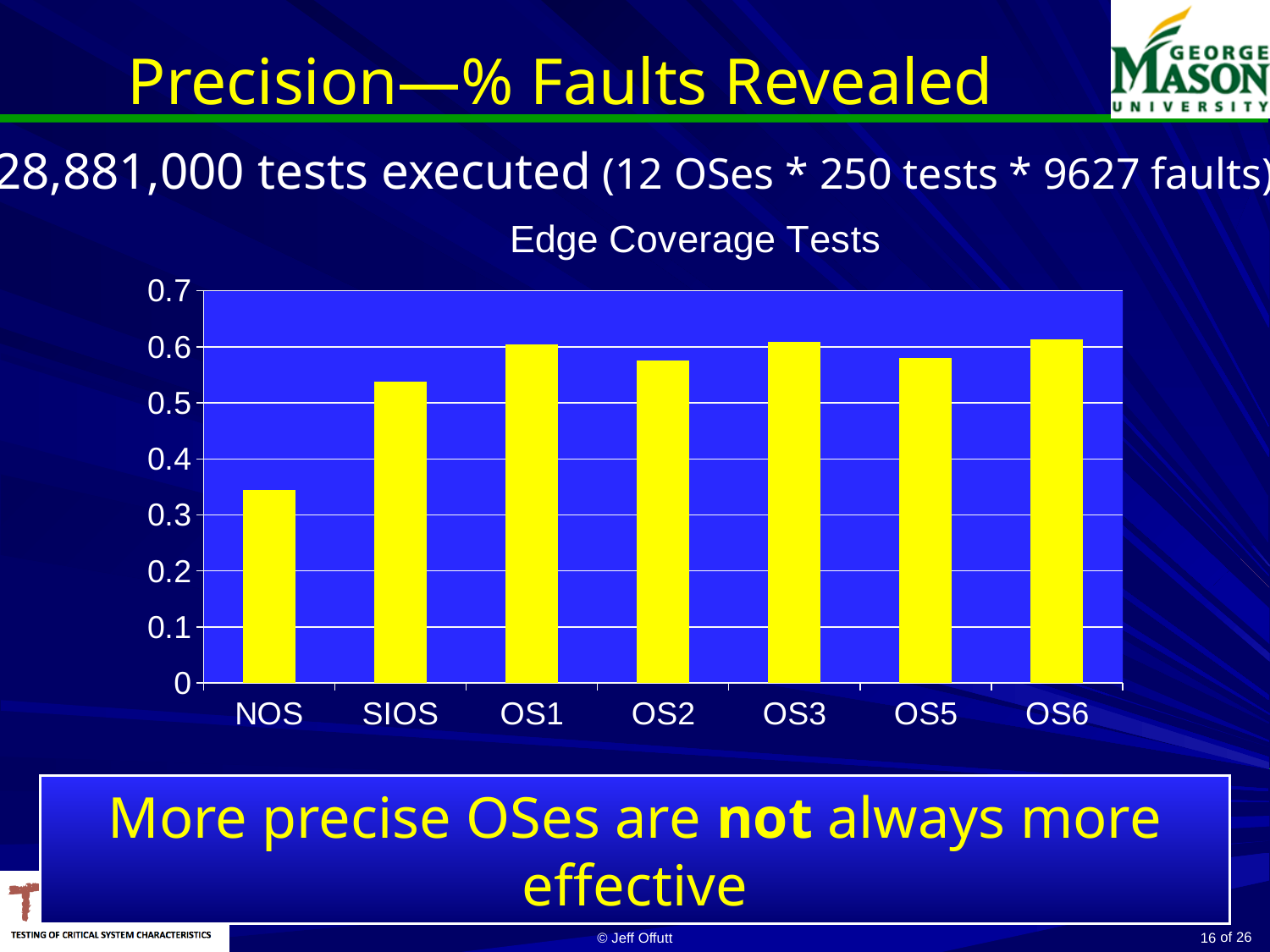
What kind of chart is shown on the slide? bar chart What is the title of the chart? Edge Coverage Tests Is the value for OS2 greater or less than 0.6? less Which category has the lowest value in the chart? NOS Is the value for SIOS greater or less than 0.5? greater Which has the larger value, NOS or SIOS? SIOS What colour are the bars in the chart? yellow How many categories are plotted on the x axis of the chart? 7 Is the value for OS5 greater or less than 0.6? less Which has the larger value, OS1 or OS2? OS1